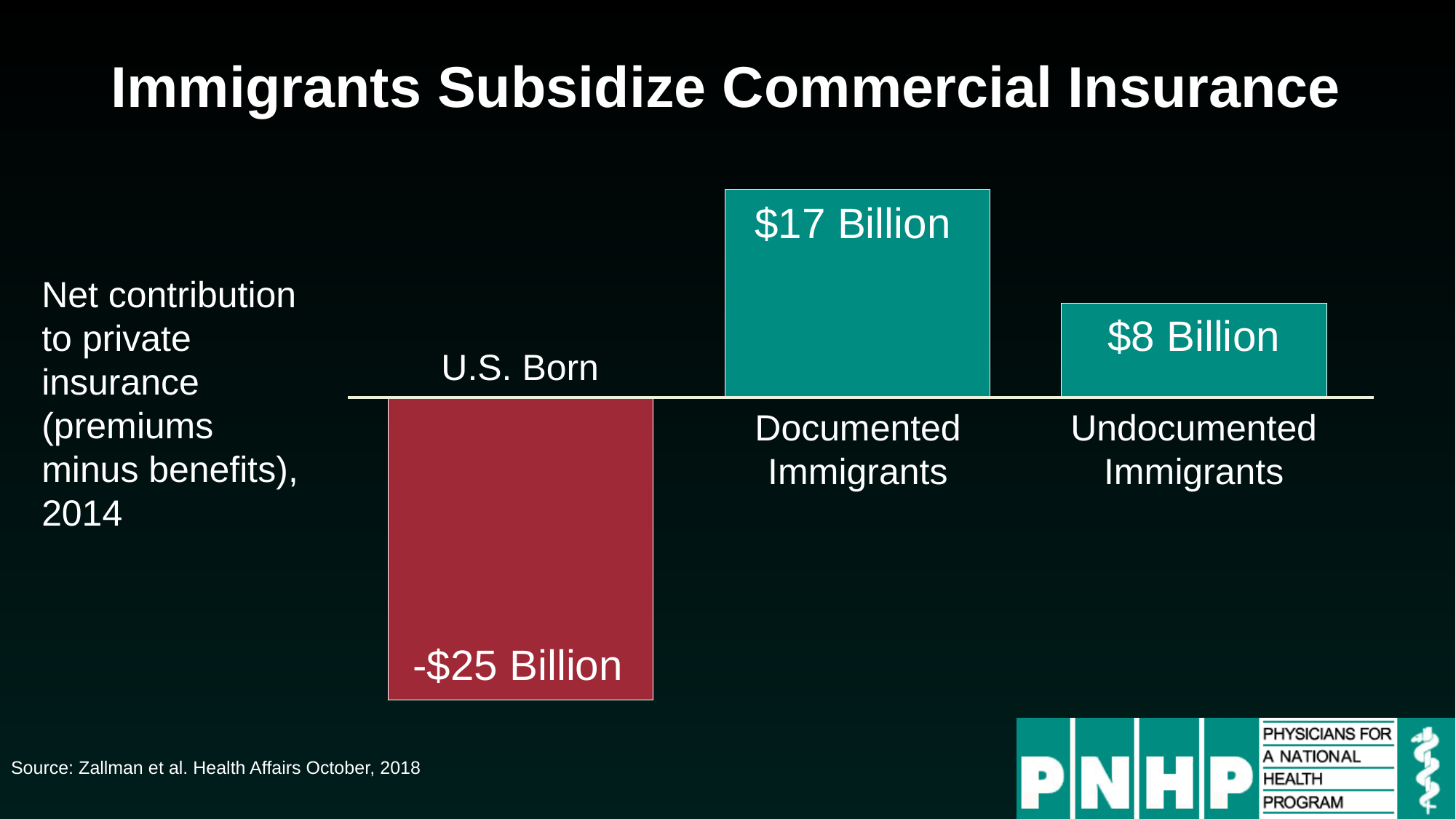
Which category has the highest net contribution to private insurance? Documented Immigrants What is the net contribution to private insurance for Undocumented Immigrants? $8 Billion Which category has the lowest net contribution to private insurance? U.S. Born What is the title of the slide? Immigrants Subsidize Commercial Insurance What colour is the bar for U.S. Born? Red What is the net contribution to private insurance for Documented Immigrants? $17 Billion What is the difference between the net contributions of Documented Immigrants and Undocumented Immigrants? $9 Billion Which category is shown with a negative value in the chart? U.S. Born What kind of chart is shown on the slide? Bar chart How many categories are shown in the chart? 3 Which is larger, the net contribution of Documented Immigrants or Undocumented Immigrants? Documented Immigrants What is the net contribution to private insurance for U.S. Born? -$25 Billion